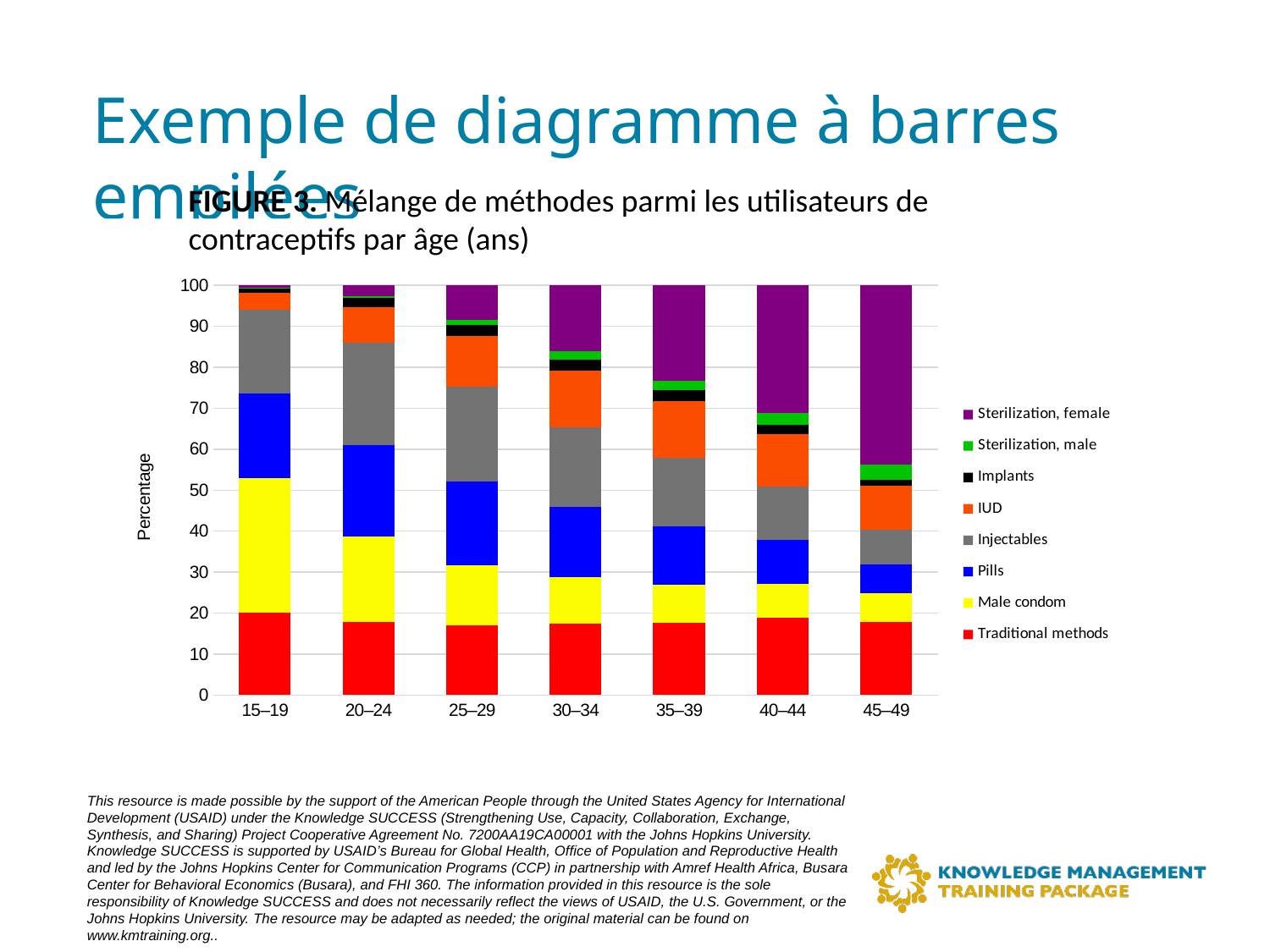
Is the value for Sterilization, female in the 45–49 group greater or less than 40? greater Is the share for Male condom larger for the 15–19 group or the 45–49 group? 15–19 Which age group has the largest share for Male condom? 15–19 How many series does the chart's legend list? 8 What is the total of the stacked bar for the 45–49 age group? 100 What kind of chart is shown on the slide? Stacked bar chart What is the label on the chart's y axis? Percentage Is the share for Sterilization, female larger for the 45–49 group or the 15–19 group? 45–49 Which age group has the largest share for Sterilization, female? 45–49 Which age group has the smallest share for Sterilization, female? 15–19 How many age groups are shown along the x axis of the chart? 7 Does the share for Sterilization, female rise or fall as age increases along the x axis? rise